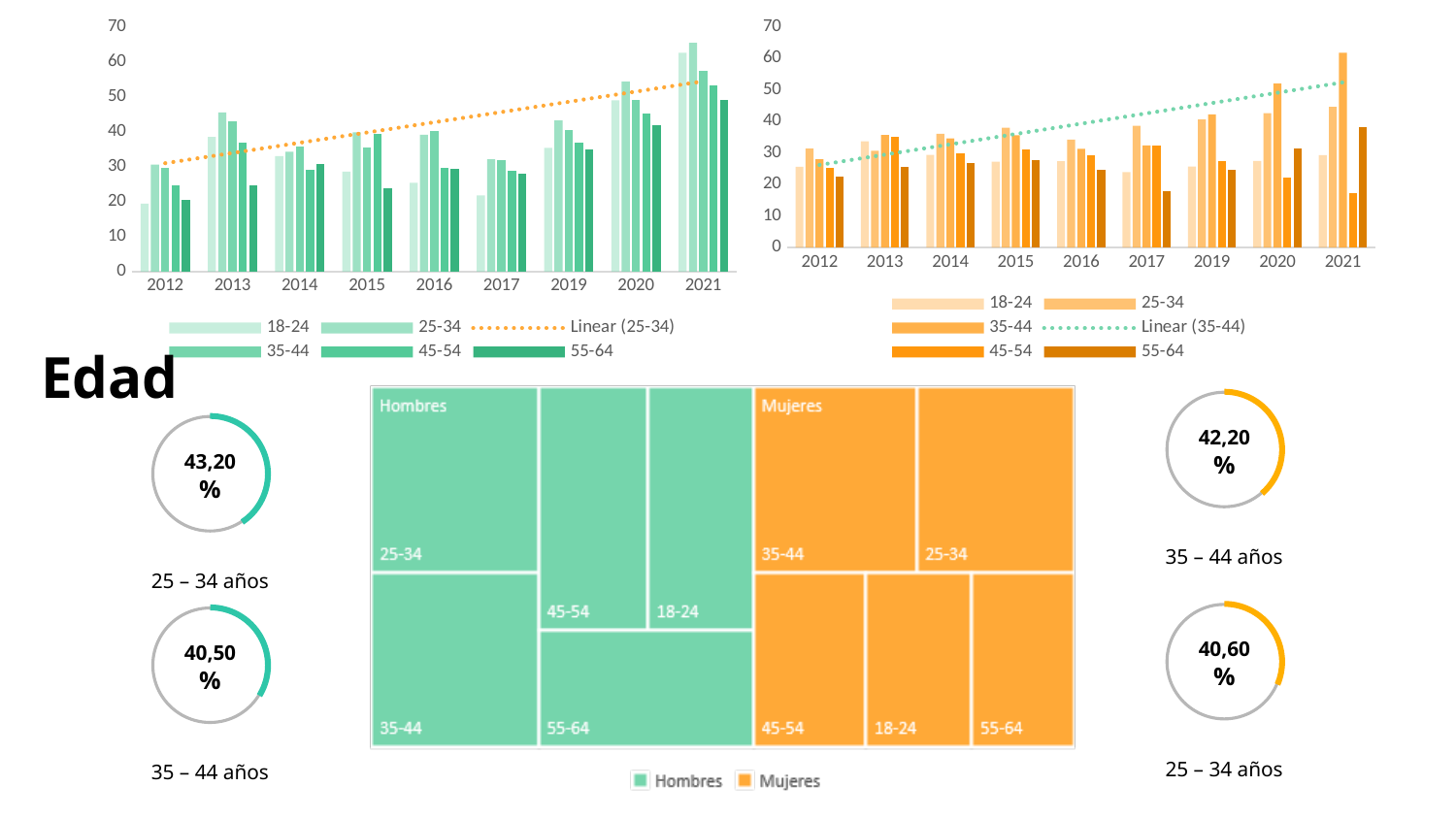
How many entries does the legend of the treemap in the centre of the slide list? 2 Which is larger: the green gauge for 35 – 44 años (40,50 %) or the orange gauge for 25 – 34 años (40,60 %)? the orange gauge for 25 – 34 años How many entries does the legend of the green bar chart at the top left list? 6 What value is shown in the orange gauge labelled 35 – 44 años on the right of the slide? 42,20 % How many years are shown on the x axis of the orange bar chart at the top right? 9 What value is shown in the green gauge labelled 25 – 34 años on the left of the slide? 43,20 % What kind of chart is the green chart at the top left of the slide? bar chart In the green bar chart at the top left, is the value for 25-34 in 2021 greater or less than 60? greater In the orange bar chart at the top right, does the dotted Linear (35-44) trendline rise or fall from 2012 to 2021? rise In the orange bar chart at the top right, is the value for 45-54 in 2021 greater or less than 20? less In the green bar chart at the top left, which year has the tallest bar? 2021 In the orange bar chart at the top right, which age group has the tallest bar in 2021? 35-44